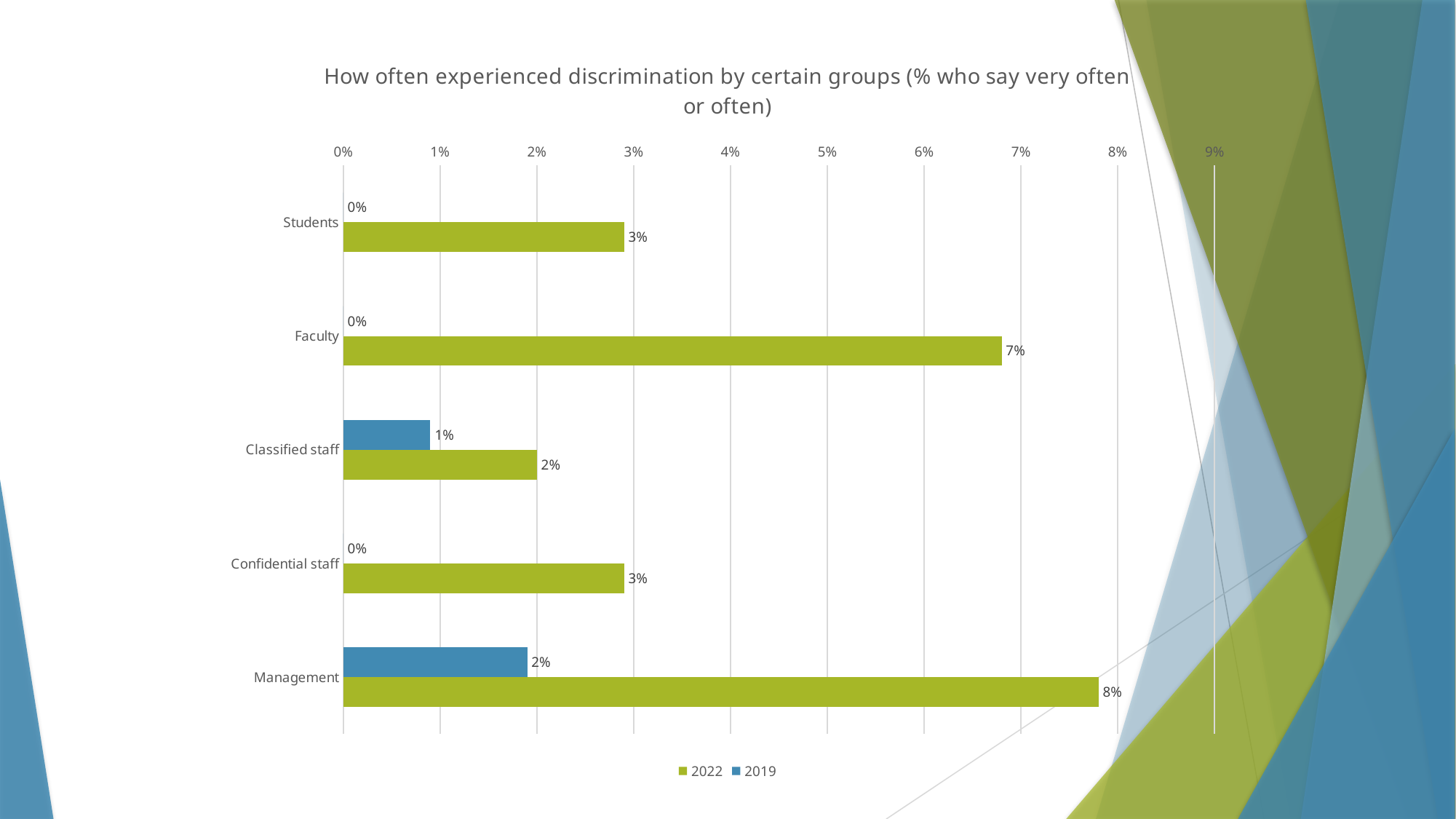
Which group has the lowest 2022 value? Classified staff What is the 2019 value for Students? 0% How many series does the legend list? 2 Which colour represents the 2019 series? Blue Which group has the highest 2022 value? Management What is the 2022 value for Faculty? 7% What kind of chart is shown on the slide? Bar chart What is the 2019 value for Classified staff? 1% What is the 2022 value for Management? 8% Which is larger, the 2022 value for Faculty or the 2022 value for Students? Faculty What is the difference between the 2022 and 2019 values for Management? 6% How many groups are shown on the chart? 5